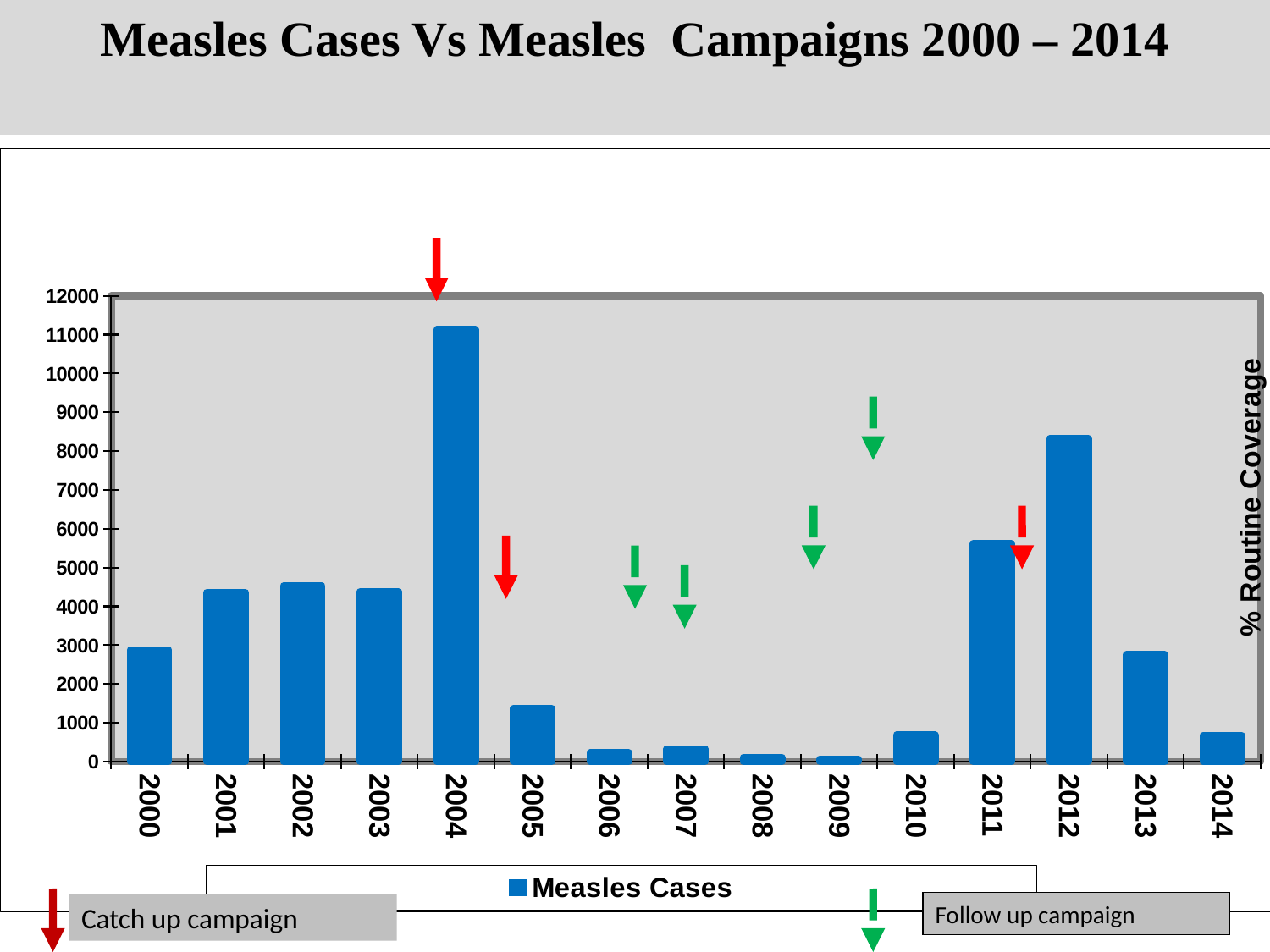
Is the value for 2004 greater or less than 10000? greater What series name is shown in the chart legend? Measles Cases Is the value for 2010 greater or less than 1000? less Is the value for 2011 greater or less than 5000? greater Which year has more measles cases, 2011 or 2013? 2011 Do the measles cases rise or fall from 2004 to 2009? fall Which year has the highest number of measles cases? 2004 How many years are shown on the x axis of the chart? 15 What kind of chart is shown on the slide? bar chart How many series does the legend list? 1